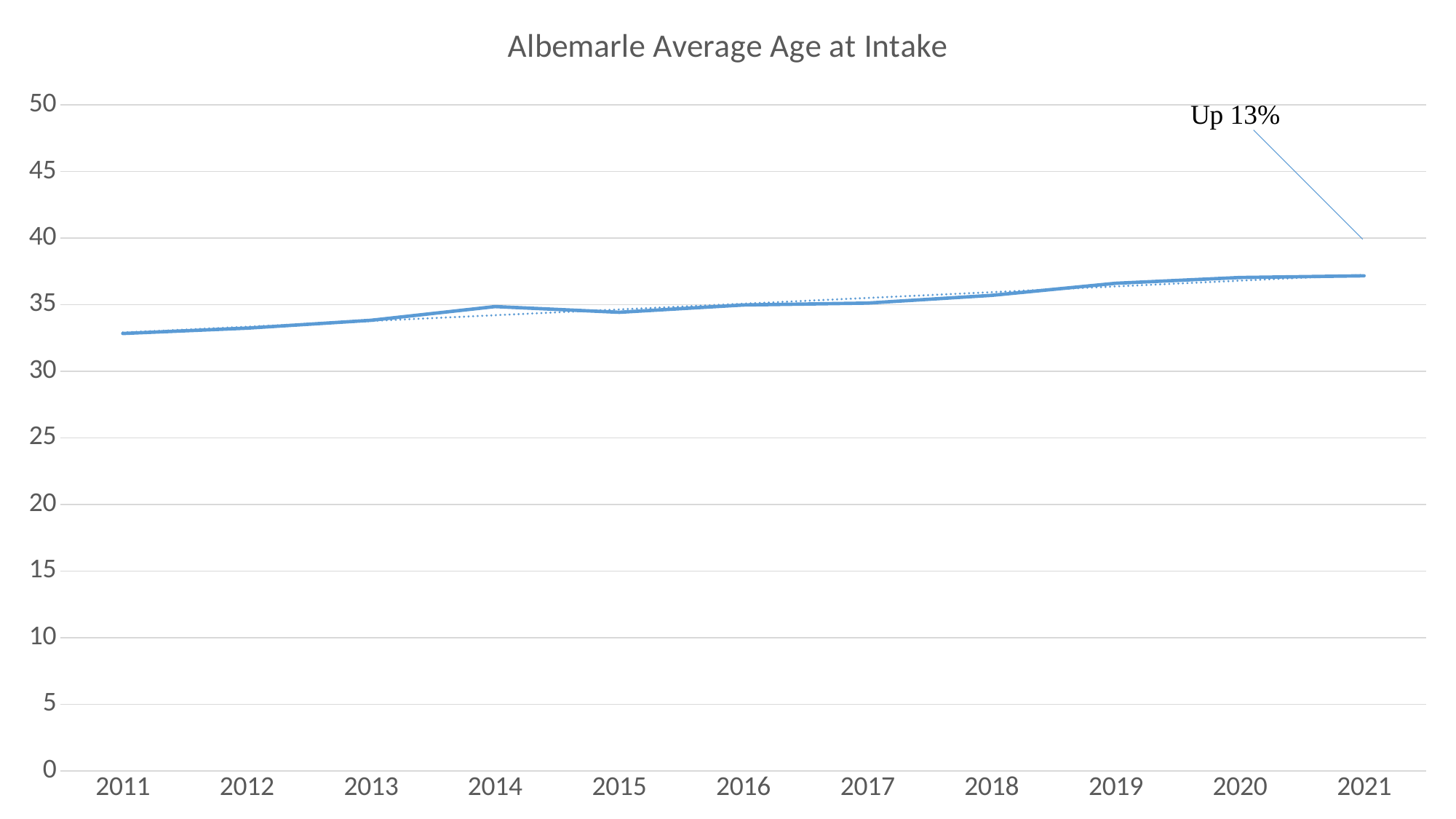
What is the title of the chart? Albemarle Average Age at Intake Which year has the larger value, 2014 or 2015? 2014 Is the value for 2021 greater or less than 35? greater Is the value for 2021 greater or less than 40? less What kind of chart is shown on the slide? line chart Is the value for 2011 greater or less than 30? greater What does the annotation text near the top right of the chart say? Up 13% How many years are plotted along the x axis? 11 What is the highest value shown on the y axis? 50 Do the values generally rise or fall from 2011 to 2021? rise Which year has the larger value, 2011 or 2021? 2021